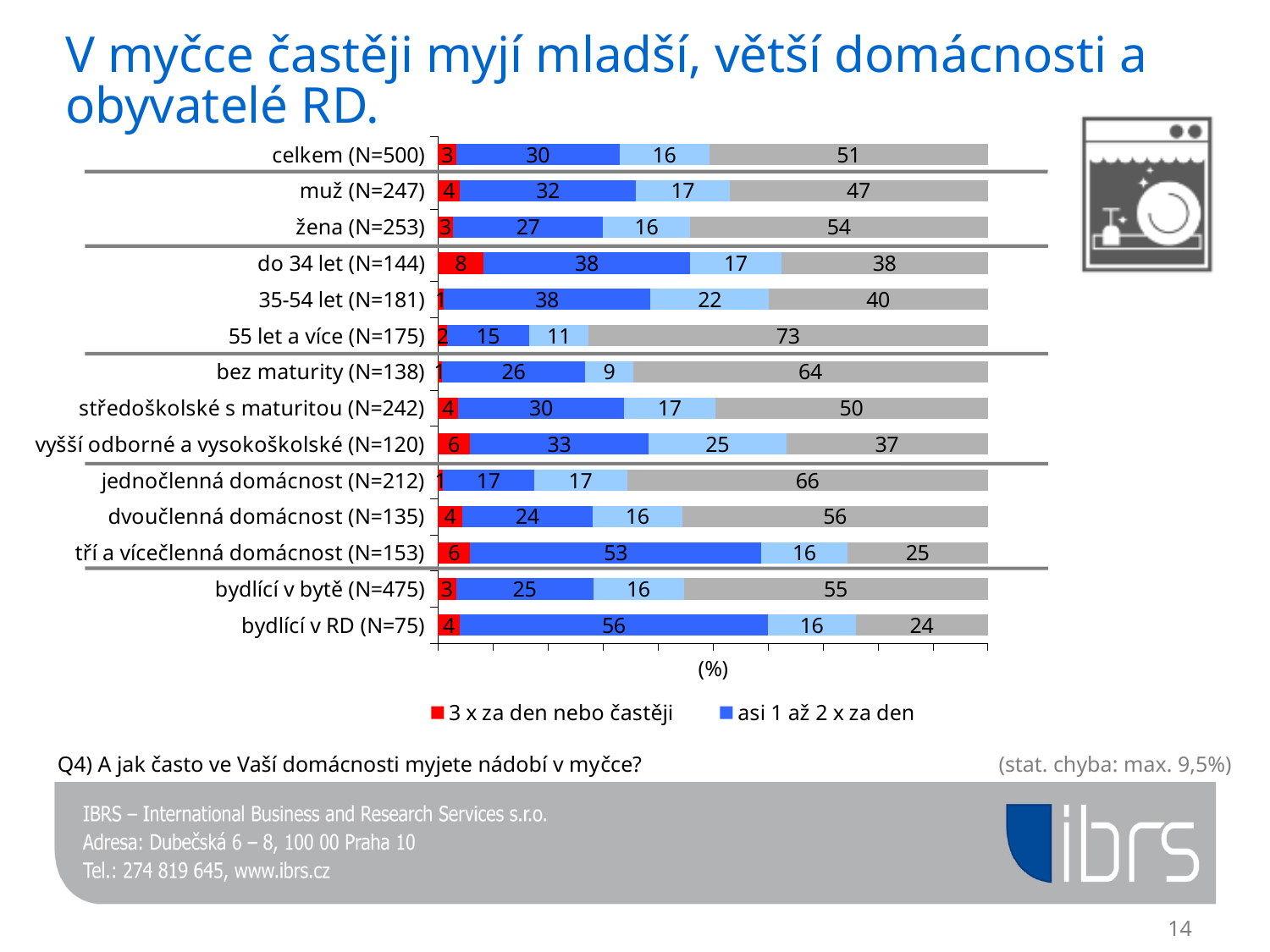
Which category has the highest value for 'asi 1 až 2 x za den'? bydlící v RD (N=75) What is the difference in 'asi 1 až 2 x za den' between 'bydlící v RD (N=75)' and 'bydlící v bytě (N=475)'? 31 What is the value of 'asi 1 až 2 x za den' for '55 let a více (N=175)'? 15 What is the total of all segments in the 'celkem (N=500)' bar? 100 What kind of chart is shown on the slide? bar chart Which category has the highest value for '3 x za den nebo častěji'? do 34 let (N=144) Which has the larger value for 'asi 1 až 2 x za den': '35-54 let (N=181)' or '55 let a více (N=175)'? 35-54 let (N=181) What colour represents '3 x za den nebo častěji' in the chart? red How many categories (rows) are plotted in the chart? 14 What is the value of '3 x za den nebo častěji' for 'do 34 let (N=144)'? 8 Which category has the lowest value for 'asi 1 až 2 x za den'? 55 let a více (N=175) What is the value of 'asi 1 až 2 x za den' for 'bydlící v RD (N=75)'? 56